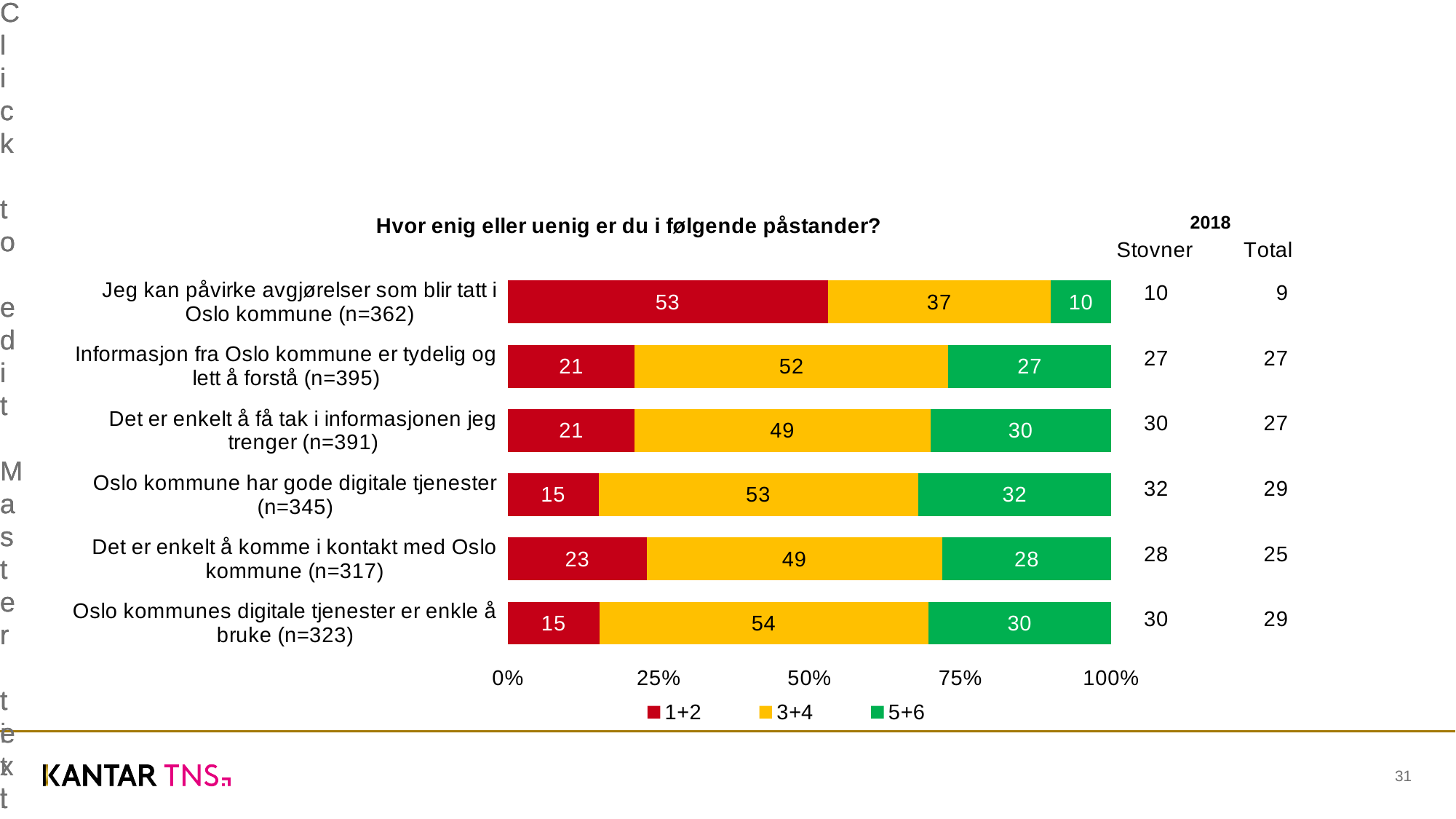
What is the value of the 5+6 series for "Oslo kommune har gode digitale tjenester (n=345)"? 32 What is the difference between the 3+4 value and the 1+2 value for "Informasjon fra Oslo kommune er tydelig og lett å forstå (n=395)"? 31 What kind of chart is shown on the slide? Stacked bar chart Which statement has the highest value for the 1+2 series? Jeg kan påvirke avgjørelser som blir tatt i Oslo kommune (n=362) What is the value of the 1+2 series for "Jeg kan påvirke avgjørelser som blir tatt i Oslo kommune (n=362)"? 53 What is the title of the chart? Hvor enig eller uenig er du i følgende påstander? Which statement has the lowest value for the 5+6 series? Jeg kan påvirke avgjørelser som blir tatt i Oslo kommune (n=362) Which is larger: the 5+6 value for "Det er enkelt å få tak i informasjonen jeg trenger (n=391)" or the 5+6 value for "Det er enkelt å komme i kontakt med Oslo kommune (n=317)"? Det er enkelt å få tak i informasjonen jeg trenger (n=391) What is the value of the 3+4 series for "Oslo kommunes digitale tjenester er enkle å bruke (n=323)"? 54 How many series does the legend list? 3 How many statements (categories) are plotted in the chart? 6 What is the Total value shown for "Jeg kan påvirke avgjørelser som blir tatt i Oslo kommune (n=362)" in the 2018 column to the right of the chart? 9